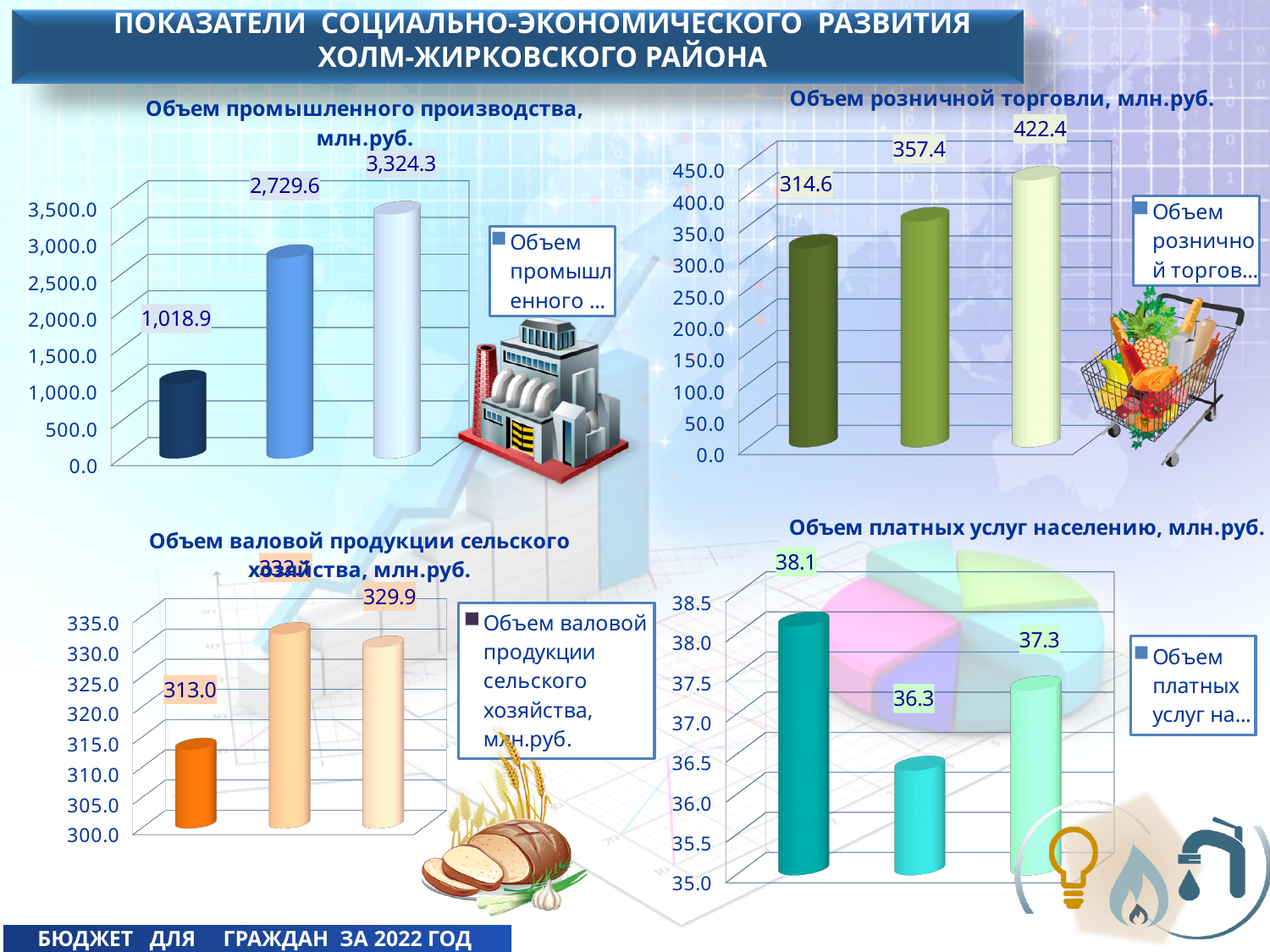
How many bars does the chart 'Объем розничной торговли, млн.руб.' contain? 3 In the chart 'Объем платных услуг населению, млн.руб.', what is the difference between the first and second bars? 1.8 In the chart 'Объем промышленного производства, млн.руб.', what is the value of the third (rightmost) bar? 3,324.3 In the chart 'Объем розничной торговли, млн.руб.', what is the value of the second (middle) bar? 357.4 In the chart 'Объем розничной торговли, млн.руб.', which bar is the highest? the third (rightmost) bar, 422.4 In the chart 'Объем платных услуг населению, млн.руб.', which is larger: the first bar or the third bar? the first bar (38.1) In the chart 'Объем промышленного производства, млн.руб.', what is the value of the first (leftmost) bar? 1,018.9 In the chart 'Объем валовой продукции сельского хозяйства, млн.руб.', which bar is the lowest? the first (leftmost) bar, 313.0 In the chart 'Объем платных услуг населению, млн.руб.', what is the value of the second (middle) bar? 36.3 In the chart 'Объем промышленного производства, млн.руб.', what is the difference between the second and first bars? 1,710.7 In the chart 'Объем валовой продукции сельского хозяйства, млн.руб.', what is the value of the first (leftmost) bar? 313.0 In the chart 'Объем розничной торговли, млн.руб.', do the values rise or fall from left to right? rise